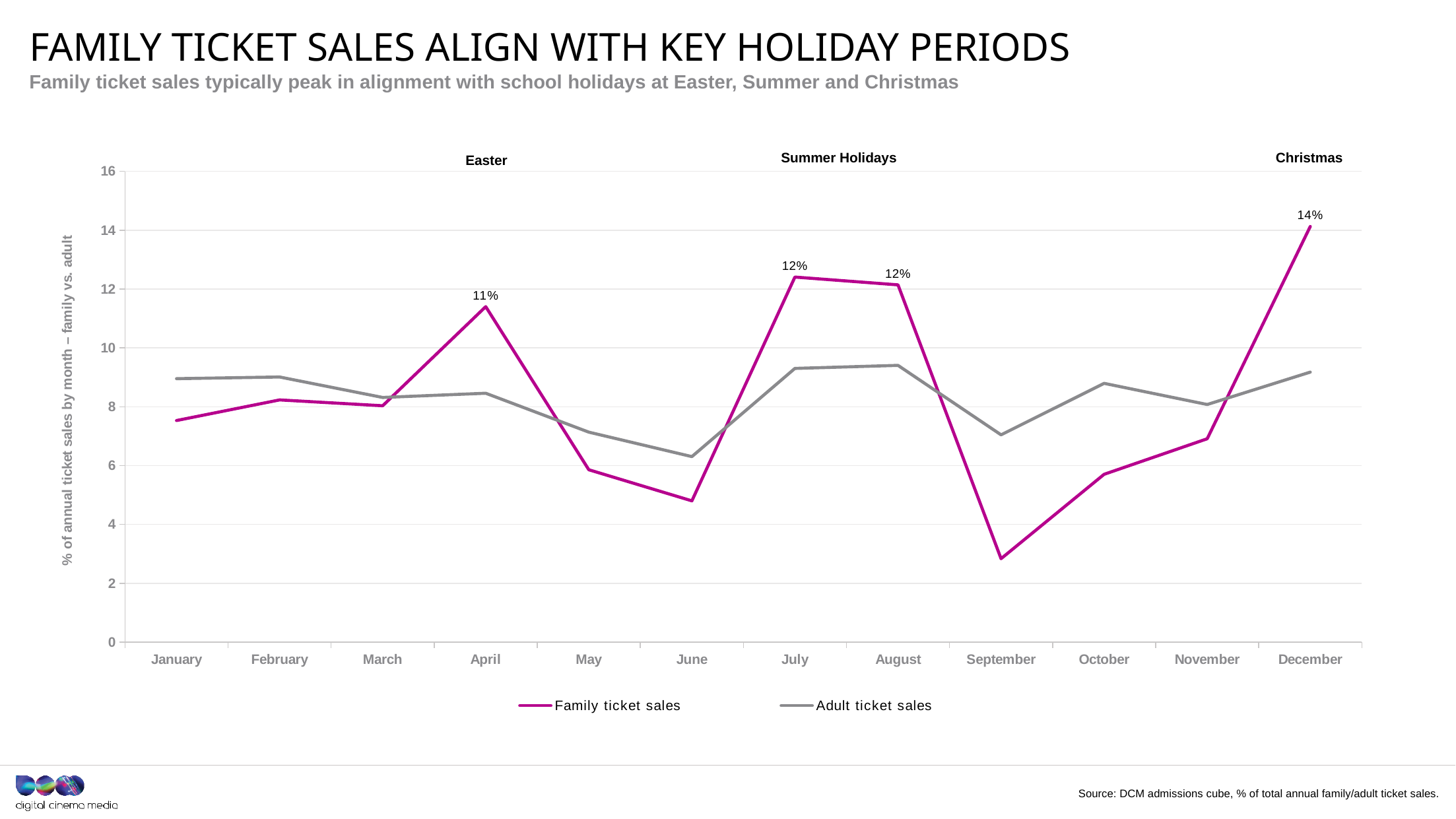
Which month has the highest Family ticket sales? December What is the difference between Family ticket sales in December and in April? 3% How many months are plotted along the x axis? 12 Which month has the lowest Family ticket sales? September What is the value for Family ticket sales in December? 14% How many series does the legend list? 2 What kind of chart is shown on the slide? Line chart What is the value for Family ticket sales in July? 12% Is the value for Adult ticket sales in January greater or less than 8? greater Is the value for Family ticket sales in September greater or less than 4? less What is the value for Family ticket sales in April? 11% In June, which is larger: Family ticket sales or Adult ticket sales? Adult ticket sales